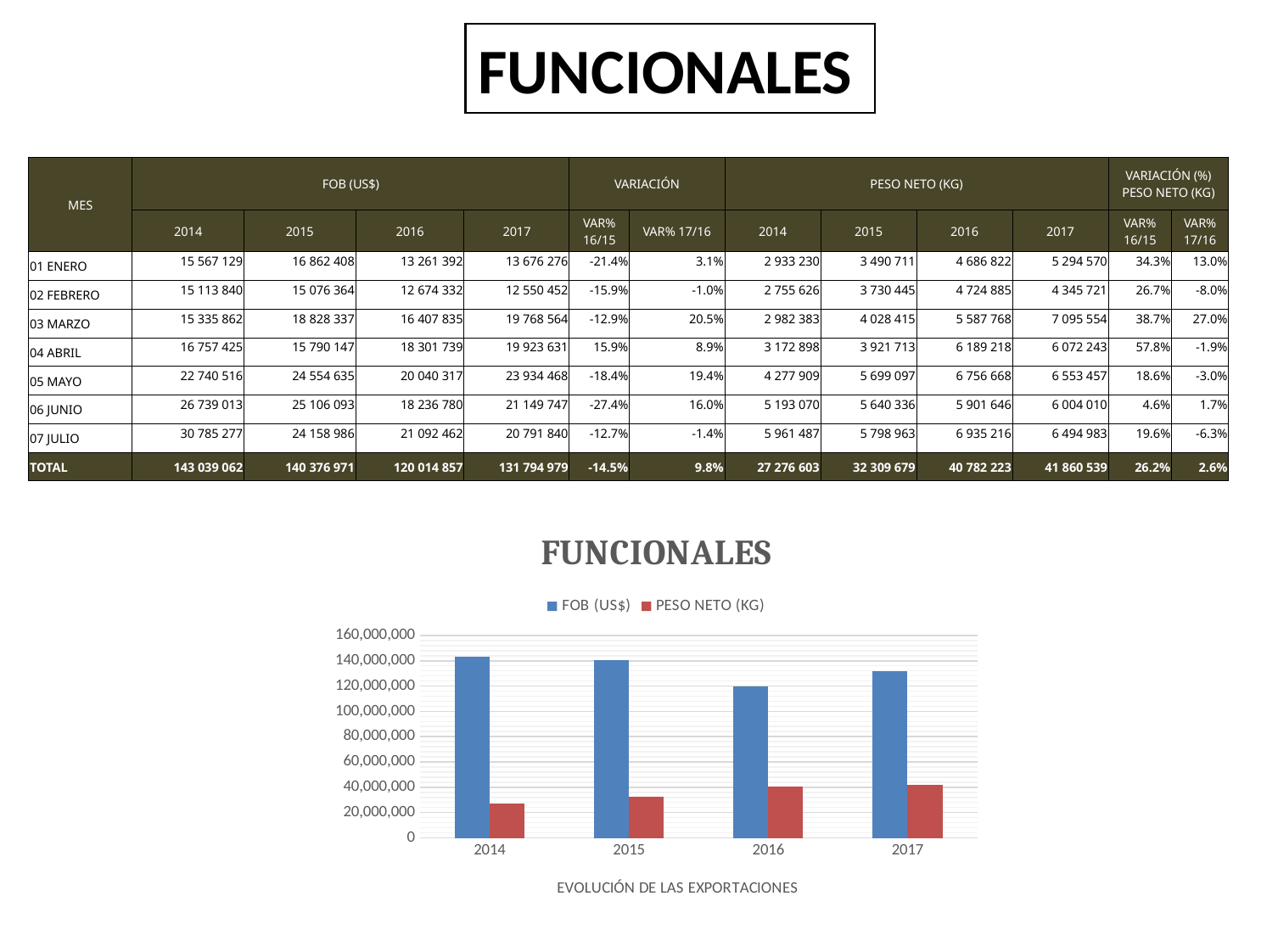
Which is larger in the chart, the PESO NETO (KG) value for 2014 or for 2016? 2016 What kind of chart is shown on the slide? bar chart Is the FOB (US$) value for 2017 greater or less than 140,000,000? less Is the FOB (US$) value for 2016 greater or less than 100,000,000? greater Which year has the lowest PESO NETO (KG) bar in the chart? 2014 How many series does the chart legend list? 2 What is the title of the chart? FUNCIONALES Which is larger in the chart, the FOB (US$) value for 2015 or for 2016? 2015 Is the PESO NETO (KG) value for 2015 greater or less than 40,000,000? less Which year has the lowest FOB (US$) bar in the chart? 2016 How many years are shown on the x axis of the chart? 4